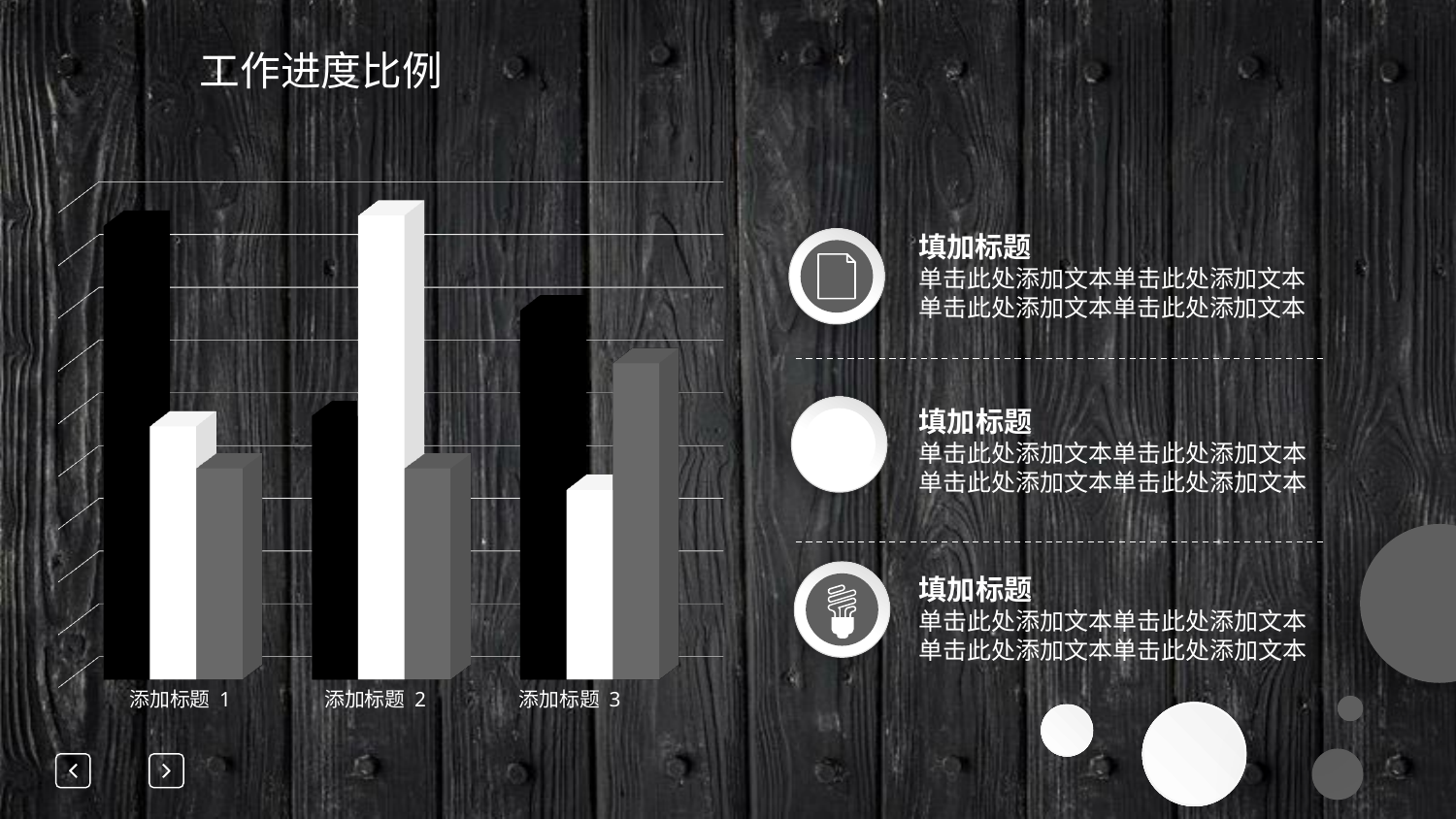
Which category has the tallest black bar? 添加标题 1 What is the label of the first category on the x axis? 添加标题 1 Which category has the shortest black bar? 添加标题 2 In category 添加标题 2, which bar is taller, the white bar or the black bar? white bar Is the white bar for 添加标题 1 taller or shorter than the white bar for 添加标题 2? shorter Is the black bar for 添加标题 3 taller or shorter than the black bar for 添加标题 2? taller What kind of chart is shown on the slide? bar chart Which category has the shortest white bar? 添加标题 3 Which category has the tallest white bar? 添加标题 2 How many categories are shown on the x axis of the chart? 3 What is the title of the slide containing the chart? 工作进度比例